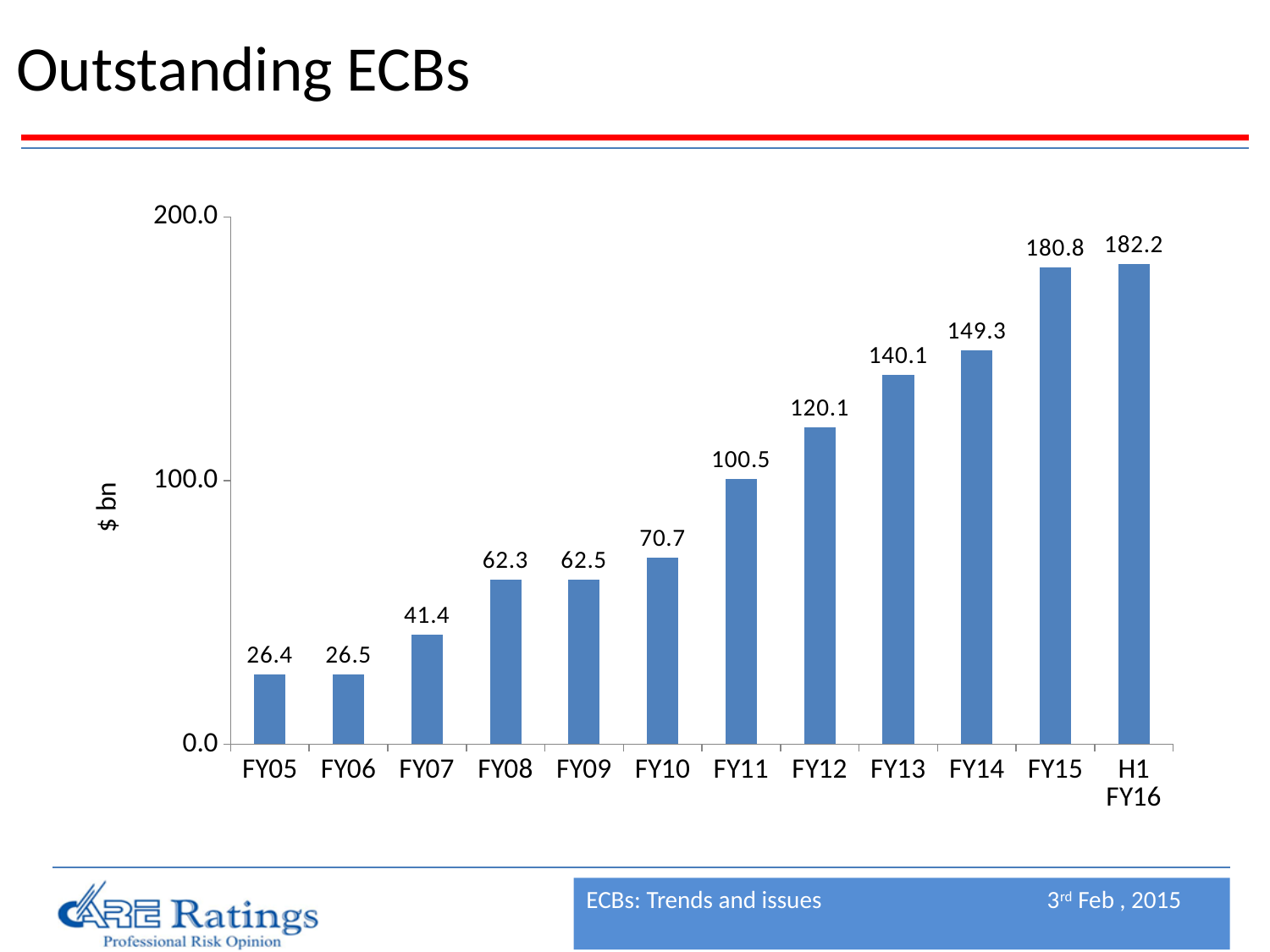
Which is larger, the value for FY10 or the value for FY13? FY13 What kind of chart is shown on the slide? bar chart What is the label on the vertical axis? $ bn How many categories are shown on the x axis? 12 What is the value for H1 FY16? 182.2 What is the value for FY11? 100.5 Which category has the lowest value? FY05 What is the value for FY07? 41.4 Which category has the highest value? H1 FY16 What is the difference between the values for FY12 and FY11? 19.6 Is the value for FY14 greater or less than 100.0? greater What is the difference between the values for FY15 and FY14? 31.5